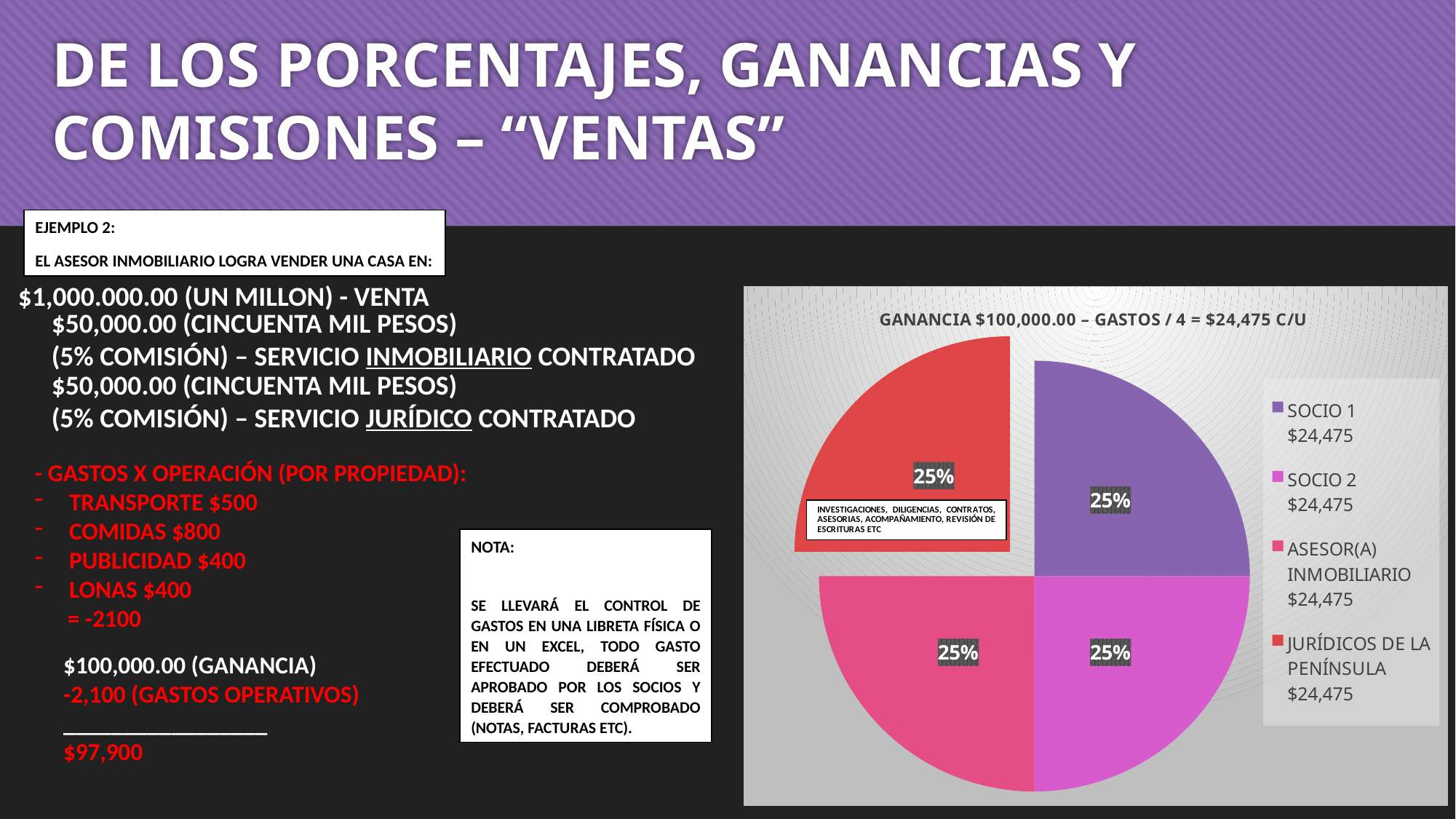
What is the title of the pie chart? GANANCIA $100,000.00 – GASTOS / 4 = $24,475 C/U How many slices does the pie chart have? 4 What amount is shown in the legend for JURÍDICOS DE LA PENÍNSULA? $24,475 What kind of chart is shown on the slide? pie chart What share of the pie does SOCIO 1 represent? 25% Which legend entry is shown in red in the pie chart? JURÍDICOS DE LA PENÍNSULA What share of the pie does JURÍDICOS DE LA PENÍNSULA represent? 25% What amount is shown in the legend for ASESOR(A) INMOBILIARIO? $24,475 What amount is shown in the legend for SOCIO 2? $24,475 What share of the pie does ASESOR(A) INMOBILIARIO represent? 25% How many entries does the legend of the pie chart list? 4